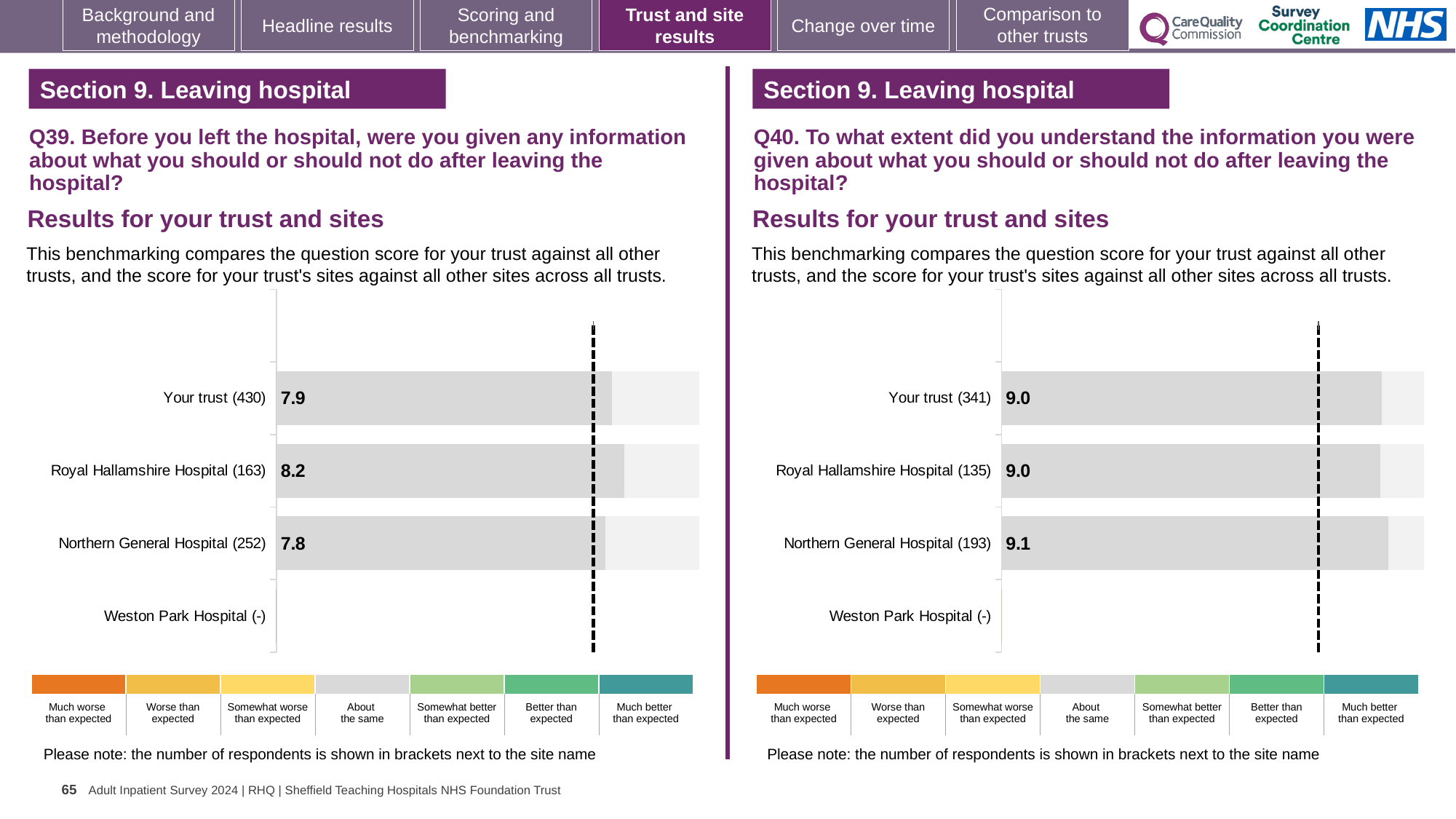
On the Q40 chart (right), what is the difference between the scores for Northern General Hospital and Royal Hallamshire Hospital? 0.1 On the Q39 chart (left), which site has the highest score? Royal Hallamshire Hospital On the Q39 chart (left), what is the score for Royal Hallamshire Hospital? 8.2 How many site/trust rows are listed on the Q39 chart (left)? 4 What kind of chart is used on the Q40 chart (right)? Bar chart On the Q40 chart (right), how many respondents are shown in brackets for Royal Hallamshire Hospital? 135 On the Q39 chart (left), what is the difference between the scores for Royal Hallamshire Hospital and Northern General Hospital? 0.4 On the Q40 chart (right), what is the score for Northern General Hospital? 9.1 On the Q40 chart (right), what is the score for Your trust? 9.0 On the Q39 chart (left), what is the score for Northern General Hospital? 7.8 On the Q39 chart (left), how many respondents are shown in brackets for Your trust? 430 On the Q39 chart (left), what is the score for Your trust? 7.9